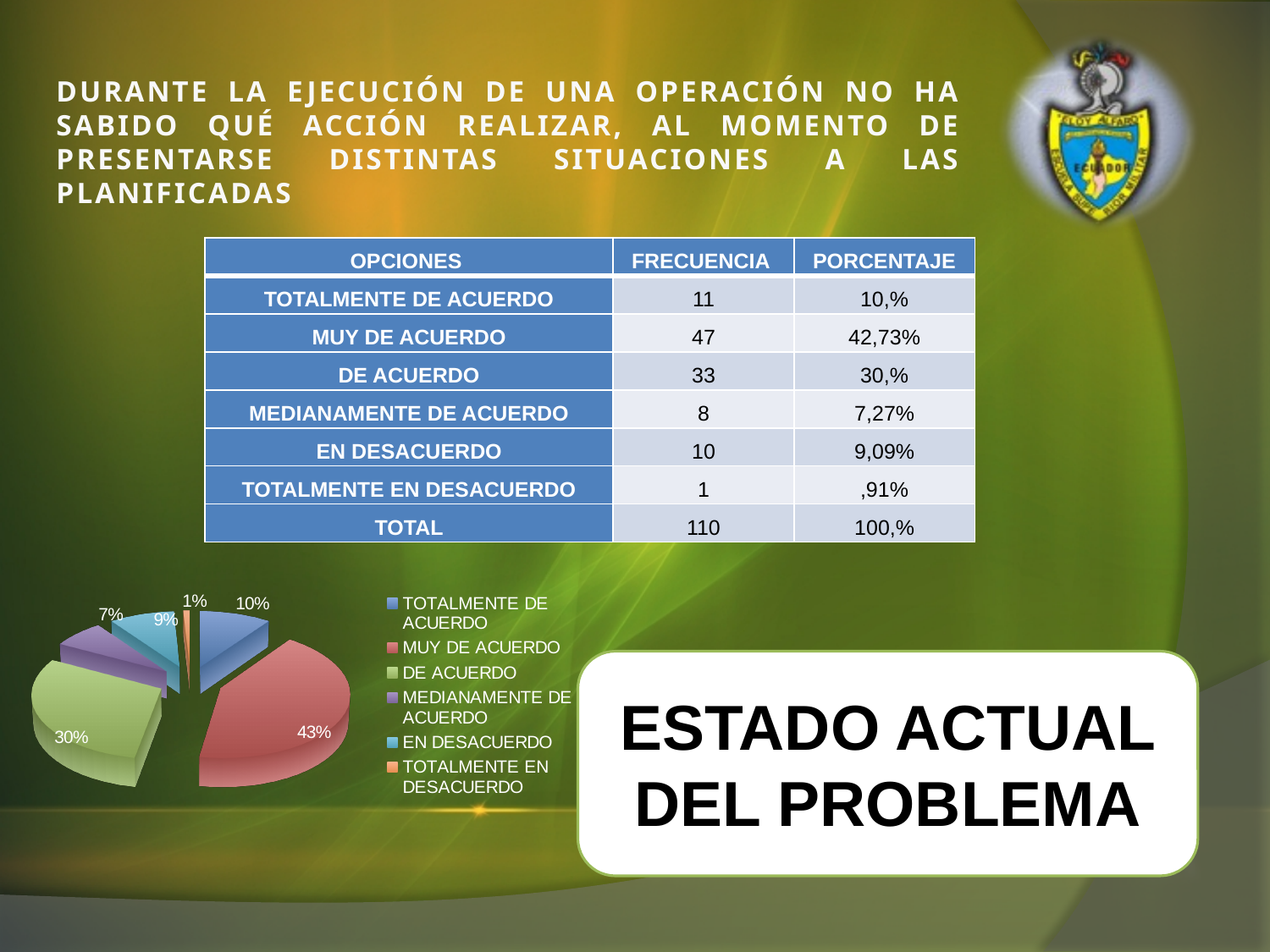
Which category has the largest slice in the pie chart? MUY DE ACUERDO In the pie chart, what share is shown for MEDIANAMENTE DE ACUERDO? 7% In the pie chart, what is the difference in percentage points between MUY DE ACUERDO and DE ACUERDO? 13 In the pie chart, what share is shown for TOTALMENTE DE ACUERDO? 10% How many categories does the legend of the pie chart list? 6 Which category has the smallest slice in the pie chart? TOTALMENTE EN DESACUERDO In the pie chart, what share is shown for DE ACUERDO? 30% In the pie chart, what share is shown for MUY DE ACUERDO? 43% In the pie chart, which slice is larger: EN DESACUERDO or MEDIANAMENTE DE ACUERDO? EN DESACUERDO In the pie chart, what share is shown for EN DESACUERDO? 9% What kind of chart is shown at the bottom left of the slide? Pie chart In the pie chart, what share is shown for TOTALMENTE EN DESACUERDO? 1%